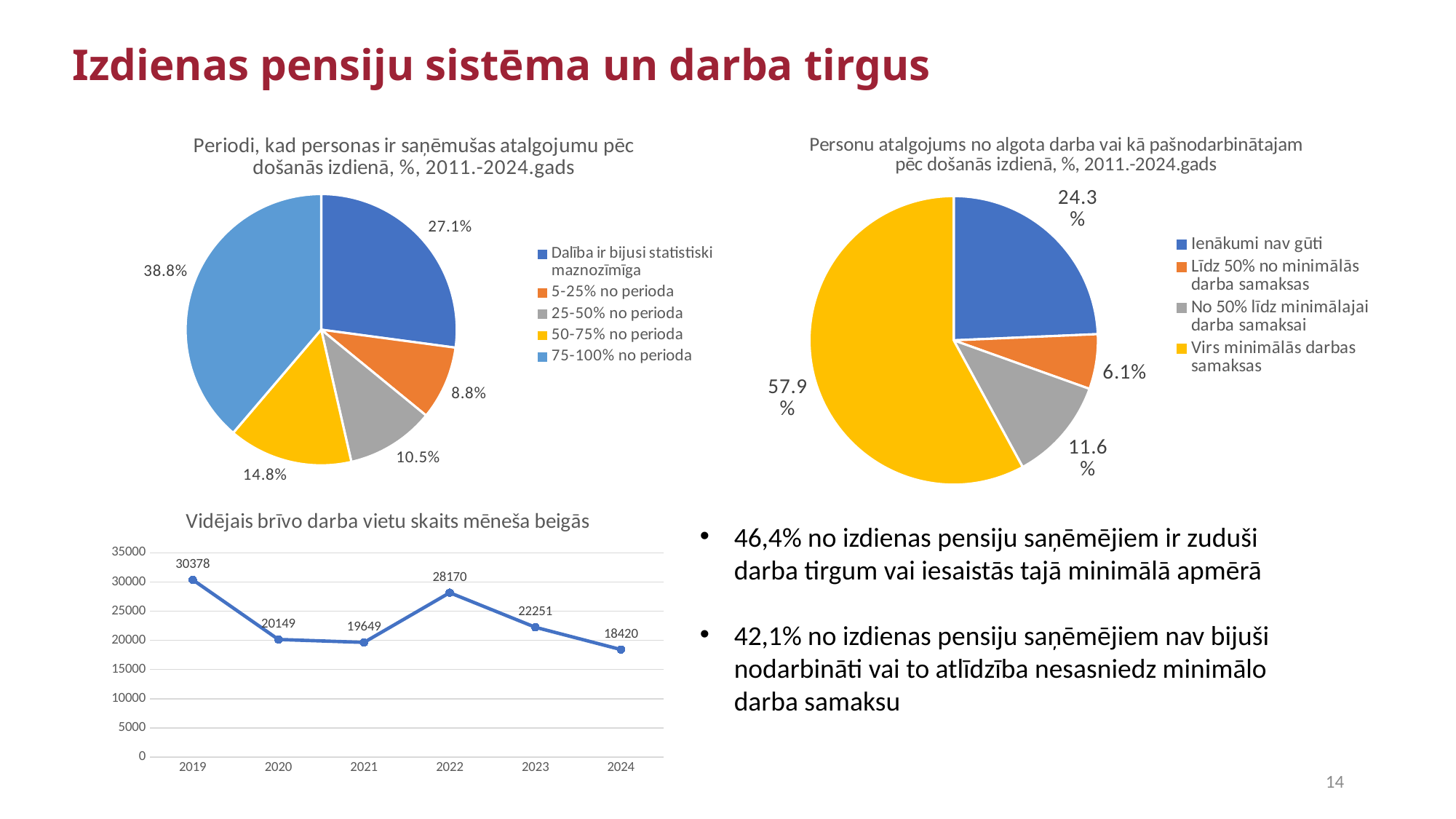
What kind of chart is 'Vidējais brīvo darba vietu skaits mēneša beigās'? Line chart In the pie chart 'Periodi, kad personas ir saņēmušas atalgojumu pēc došanās izdienā', what share is labelled for '75-100% no perioda'? 38.8% In the chart 'Vidējais brīvo darba vietu skaits mēneša beigās', which year has the lowest value? 2024 In the pie chart 'Personu atalgojums no algota darba vai kā pašnodarbinātajam pēc došanās izdienā', what share is labelled for 'Ienākumi nav gūti'? 24.3% In the pie chart 'Personu atalgojums no algota darba vai kā pašnodarbinātajam pēc došanās izdienā', which is larger: 'Līdz 50% no minimālās darba samaksas' or 'No 50% līdz minimālajai darba samaksai'? No 50% līdz minimālajai darba samaksai In the chart 'Vidējais brīvo darba vietu skaits mēneša beigās', what is the value for 2022? 28170 In the pie chart 'Personu atalgojums no algota darba vai kā pašnodarbinātajam pēc došanās izdienā', which category has the largest share? Virs minimālās darbas samaksas In the pie chart 'Personu atalgojums no algota darba vai kā pašnodarbinātajam pēc došanās izdienā', what colour is the slice for 'Virs minimālās darbas samaksas'? Yellow In the pie chart 'Periodi, kad personas ir saņēmušas atalgojumu pēc došanās izdienā', how many categories does the legend list? 5 In the chart 'Vidējais brīvo darba vietu skaits mēneša beigās', what is the difference between the values for 2019 and 2020? 10229 In the pie chart 'Periodi, kad personas ir saņēmušas atalgojumu pēc došanās izdienā', which category has the smallest share? 5-25% no perioda In the pie chart 'Periodi, kad personas ir saņēmušas atalgojumu pēc došanās izdienā', what is the difference between the shares for '75-100% no perioda' and 'Dalība ir bijusi statistiski maznozīmīga'? 11.7%